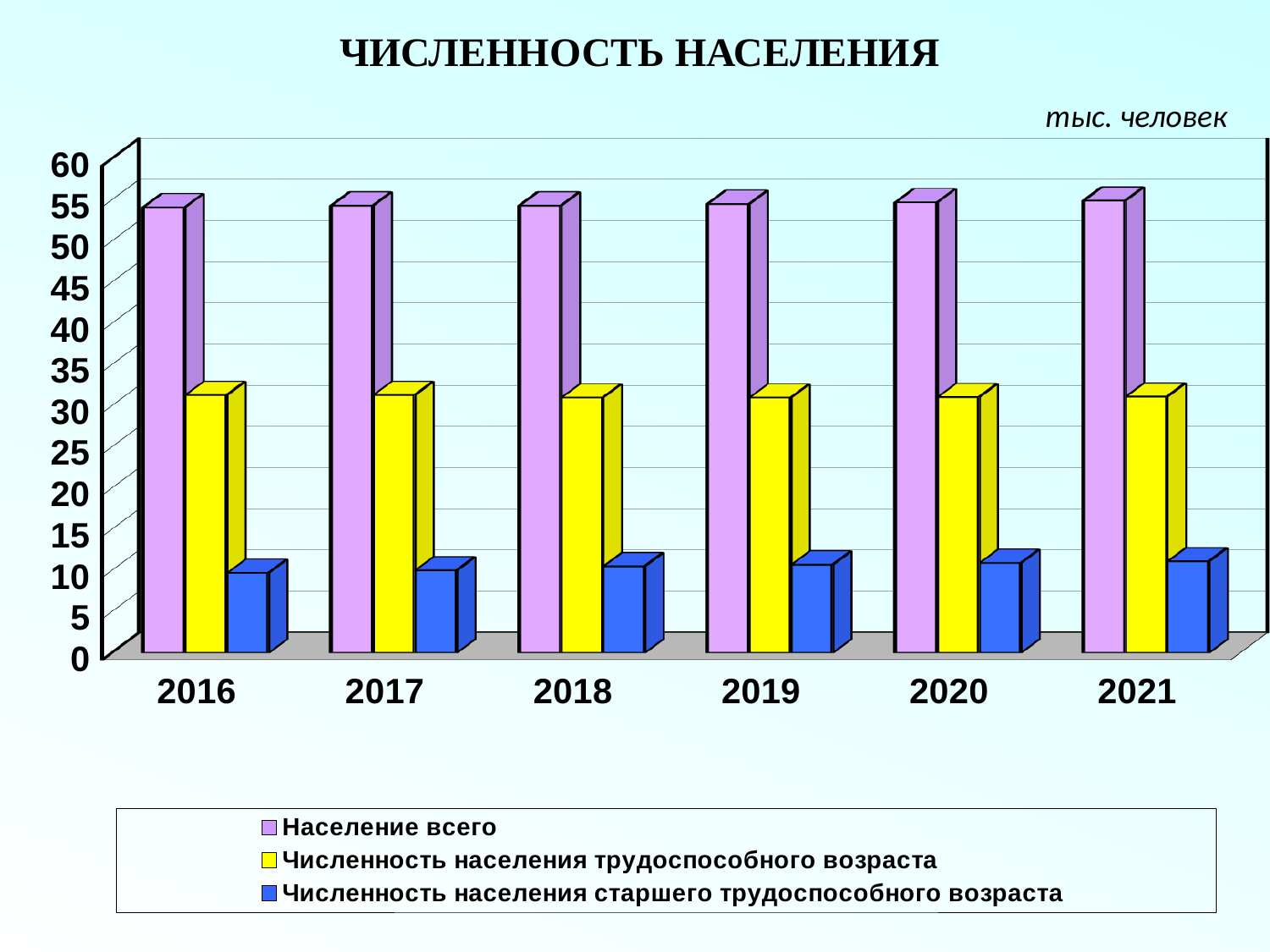
Is the value for Численность населения трудоспособного возраста in 2018 greater or less than 25? greater In 2019, which is larger: Население всего or Численность населения трудоспособного возраста? Население всего Is the value for Население всего in 2016 greater or less than 50? greater How many series does the legend list? 3 Which series has the lowest values across all years? Численность населения старшего трудоспособного возраста Is the value for Численность населения трудоспособного возраста in 2021 greater or less than 40? less What unit is indicated for the values in the chart? тыс. человек What kind of chart is shown on the slide? bar chart How many years are shown on the x axis of the chart? 6 What is the title of the chart? ЧИСЛЕННОСТЬ НАСЕЛЕНИЯ